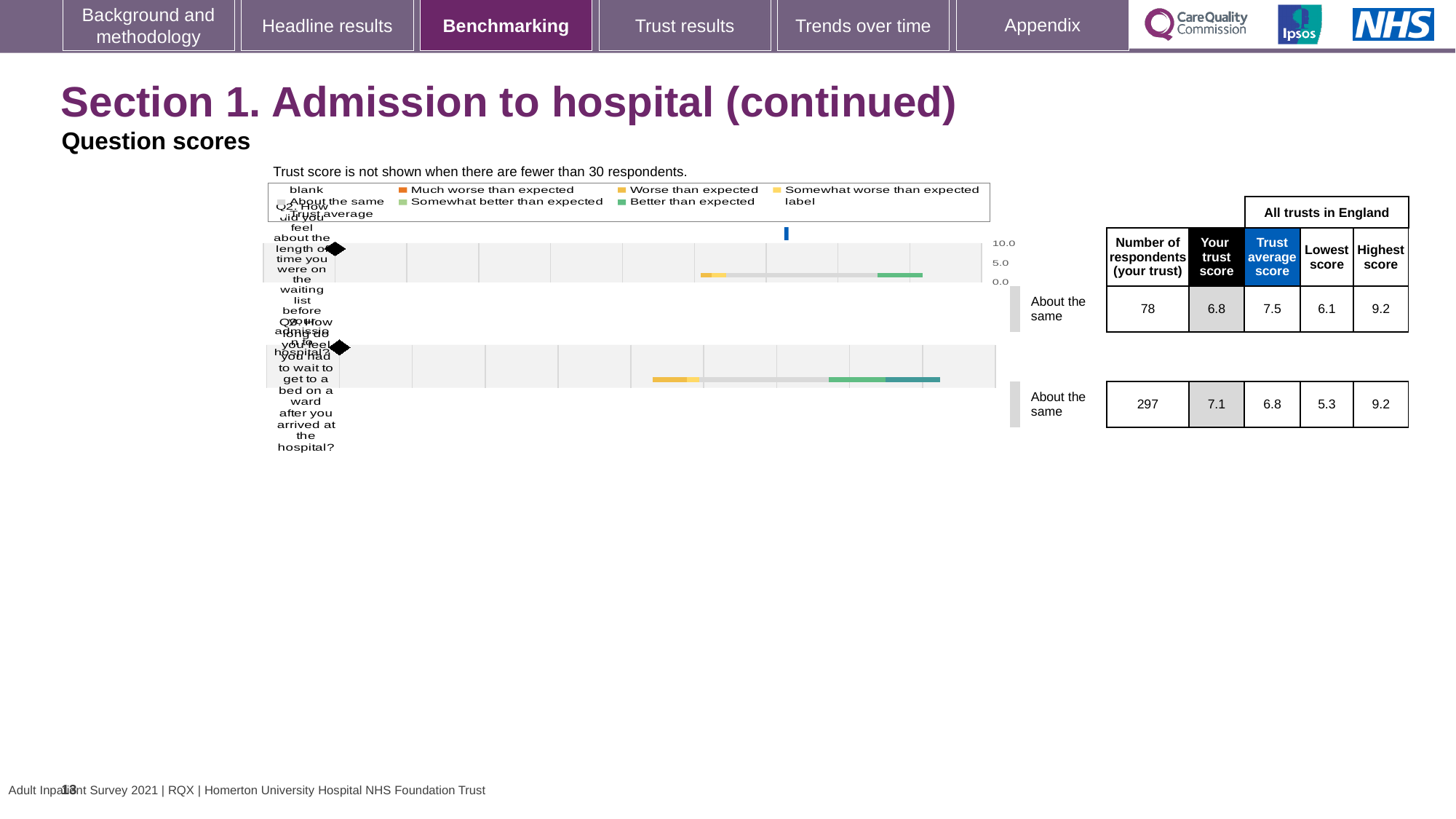
For Q2, how much higher is the trust average score than your trust score? 0.7 What is the trust average score for Q2? 7.5 For Q3, which is larger: your trust score or the trust average score? Your trust score How many questions are charted on this slide? 2 For Q3, what is the difference between the highest score and the lowest score across all trusts in England? 3.9 What colour represents 'Much worse than expected' in the chart legend? Orange What benchmark category is shown for Q3? About the same Is the trust score for Q2 greater or less than 5.0 on the chart axis? greater For Q2, which is larger: your trust score or the trust average score? Trust average score What is the trust score for Q3 (how long did you feel you had to wait to get to a bed on a ward)? 7.1 What is the number of respondents for Q3? 297 What is the trust score for Q2 (how did you feel about the length of time you were on the waiting list before admission)? 6.8